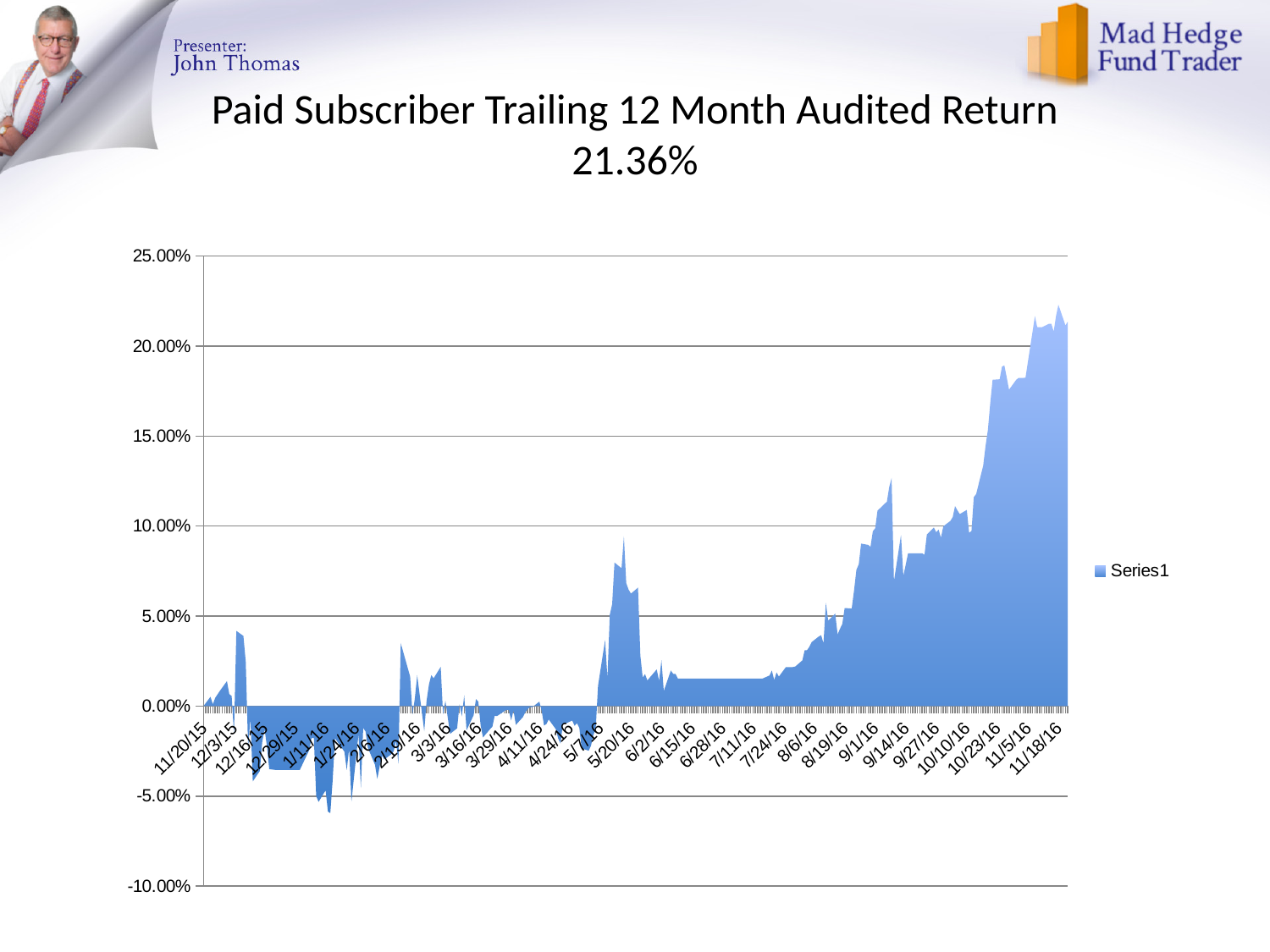
Is the value at 1/24/16 greater or less than 0.00%? less What is the title of the chart? Paid Subscriber Trailing 12 Month Audited Return 21.36% Is the value at 11/18/16 greater or less than 20.00%? greater Is the value at 8/6/16 greater or less than 5.00%? less Which is larger, the value at 9/1/16 or the value at 6/15/16? 9/1/16 What kind of chart is shown on the slide? Area chart Which is larger, the value at 11/18/16 or the value at 11/20/15? 11/18/16 What is the name of the series shown in the legend? Series1 What is the highest value shown on the y axis? 25.00% How many series does the legend list? 1 Overall, do the values rise or fall from 11/20/15 to 11/18/16? Rise